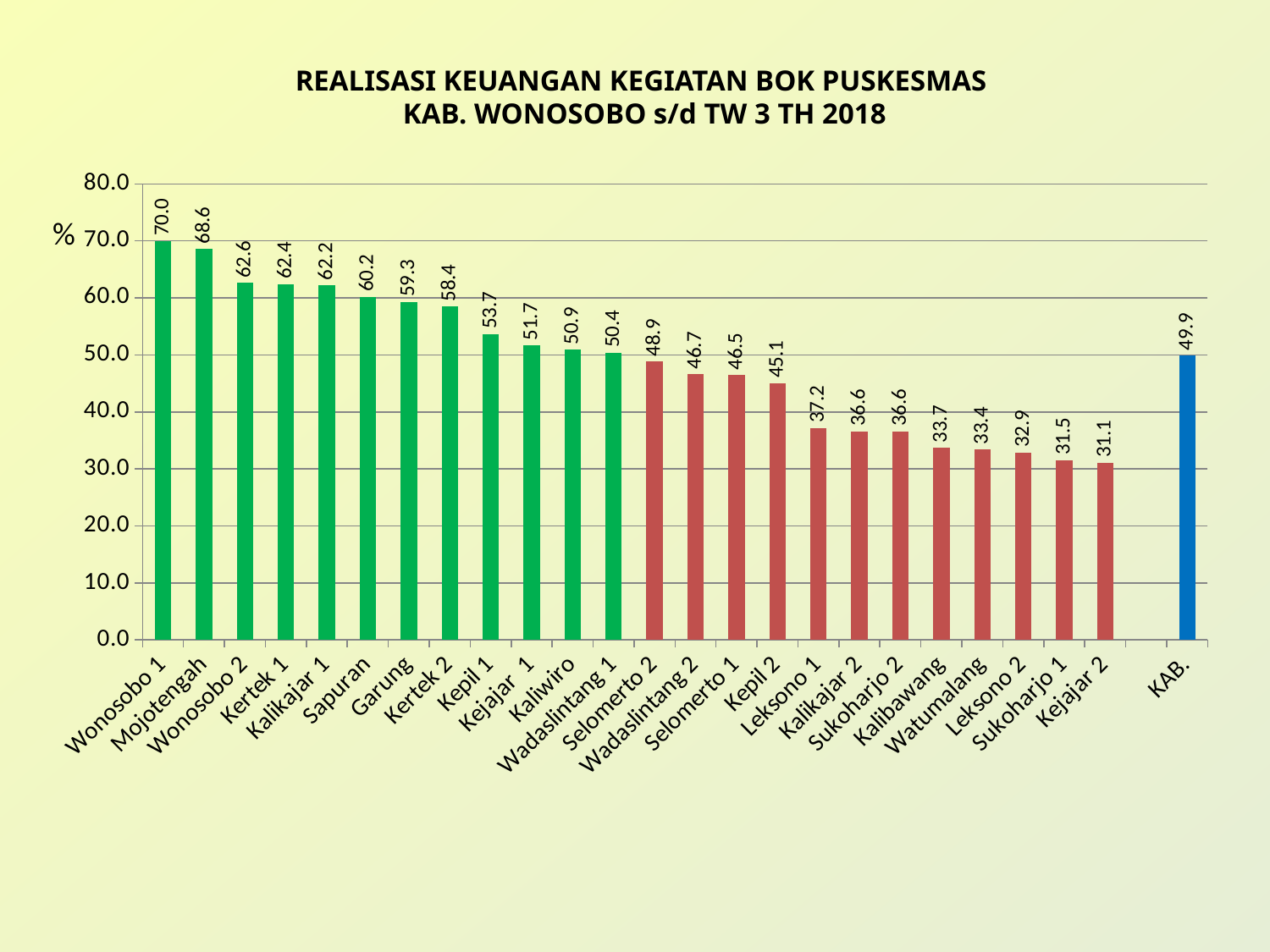
What is the value for Wonosobo 1? 70.0 What is the value for Kalibawang? 33.7 What is the value for Selomerto 2? 48.9 Which category has the highest value? Wonosobo 1 How many bars are plotted on the chart? 25 Is the value for Sapuran greater or less than 50.0? greater What is the value for KAB.? 49.9 What kind of chart is shown on the slide? Bar chart What is the difference between the values for Wonosobo 1 and Kejajar 2? 38.9 Which category has the lowest value? Kejajar 2 Which is larger, the value for Kepil 1 or the value for Kepil 2? Kepil 1 What is the difference between the values for Mojotengah and KAB.? 18.7